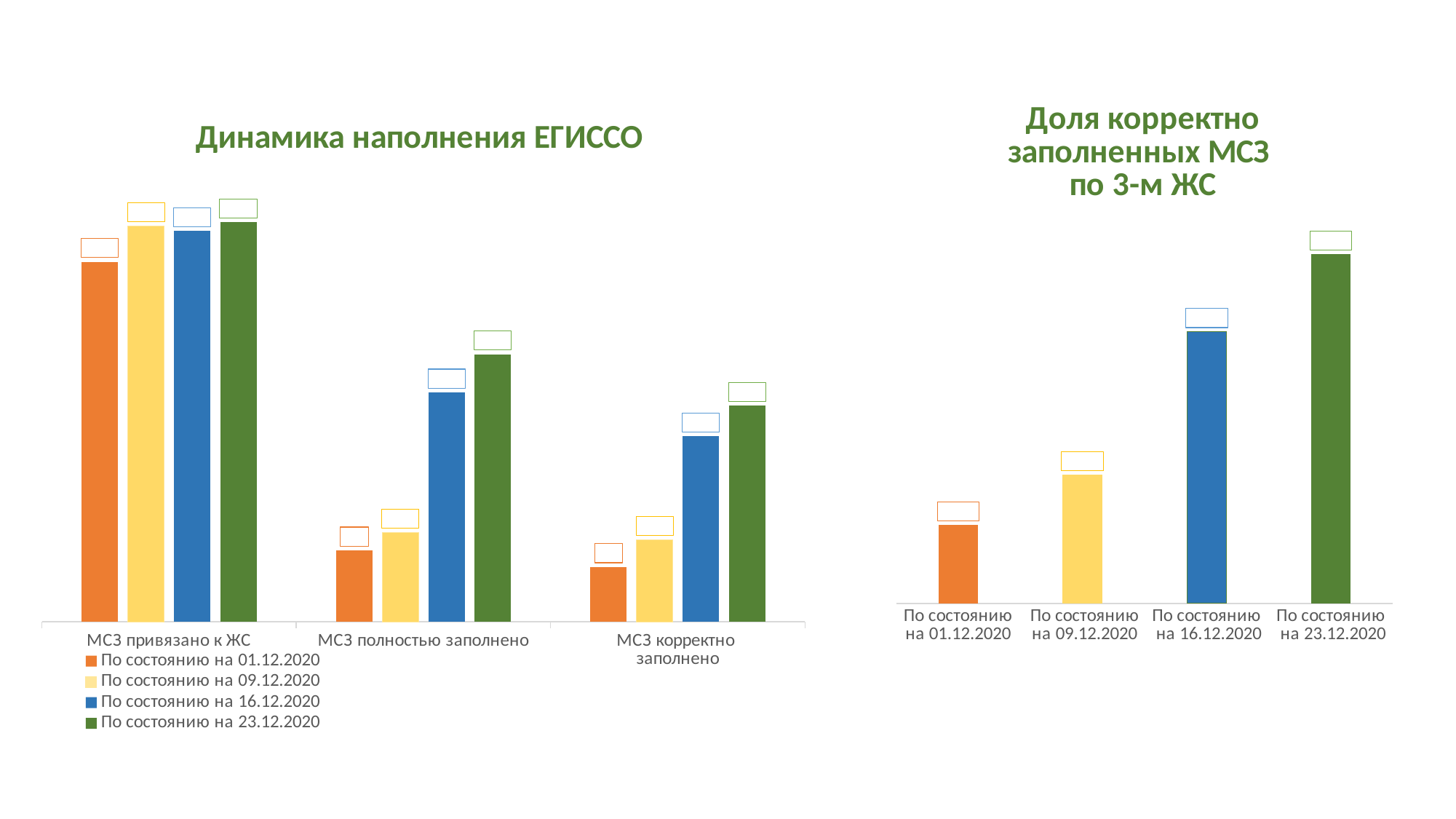
In the left chart "Динамика наполнения ЕГИССО", do the bars for "МСЗ корректно заполнено" rise or fall from 01.12.2020 to 23.12.2020? rise In the right chart "Доля корректно заполненных МСЗ по 3-м ЖС", do the values rise or fall from 01.12.2020 to 23.12.2020? rise In the right chart "Доля корректно заполненных МСЗ по 3-м ЖС", which date has the highest bar? По состоянию на 23.12.2020 In the left chart "Динамика наполнения ЕГИССО", which series has the lowest bar in the category "МСЗ корректно заполнено"? По состоянию на 01.12.2020 In the left chart "Динамика наполнения ЕГИССО", for the category "МСЗ полностью заполнено", which is larger: the bar for 16.12.2020 or the bar for 09.12.2020? 16.12.2020 What type of chart is the right chart titled "Доля корректно заполненных МСЗ по 3-м ЖС"? bar chart How many categories are shown on the x axis of the left chart "Динамика наполнения ЕГИССО"? 3 In the left chart "Динамика наполнения ЕГИССО", which category has the tallest bars overall? МСЗ привязано к ЖС How many series does the legend of the left chart "Динамика наполнения ЕГИССО" list? 4 In the left chart "Динамика наполнения ЕГИССО", what colour represents the series "По состоянию на 23.12.2020"? green What type of chart is the left chart titled "Динамика наполнения ЕГИССО"? bar chart How many bars are shown in the right chart "Доля корректно заполненных МСЗ по 3-м ЖС"? 4